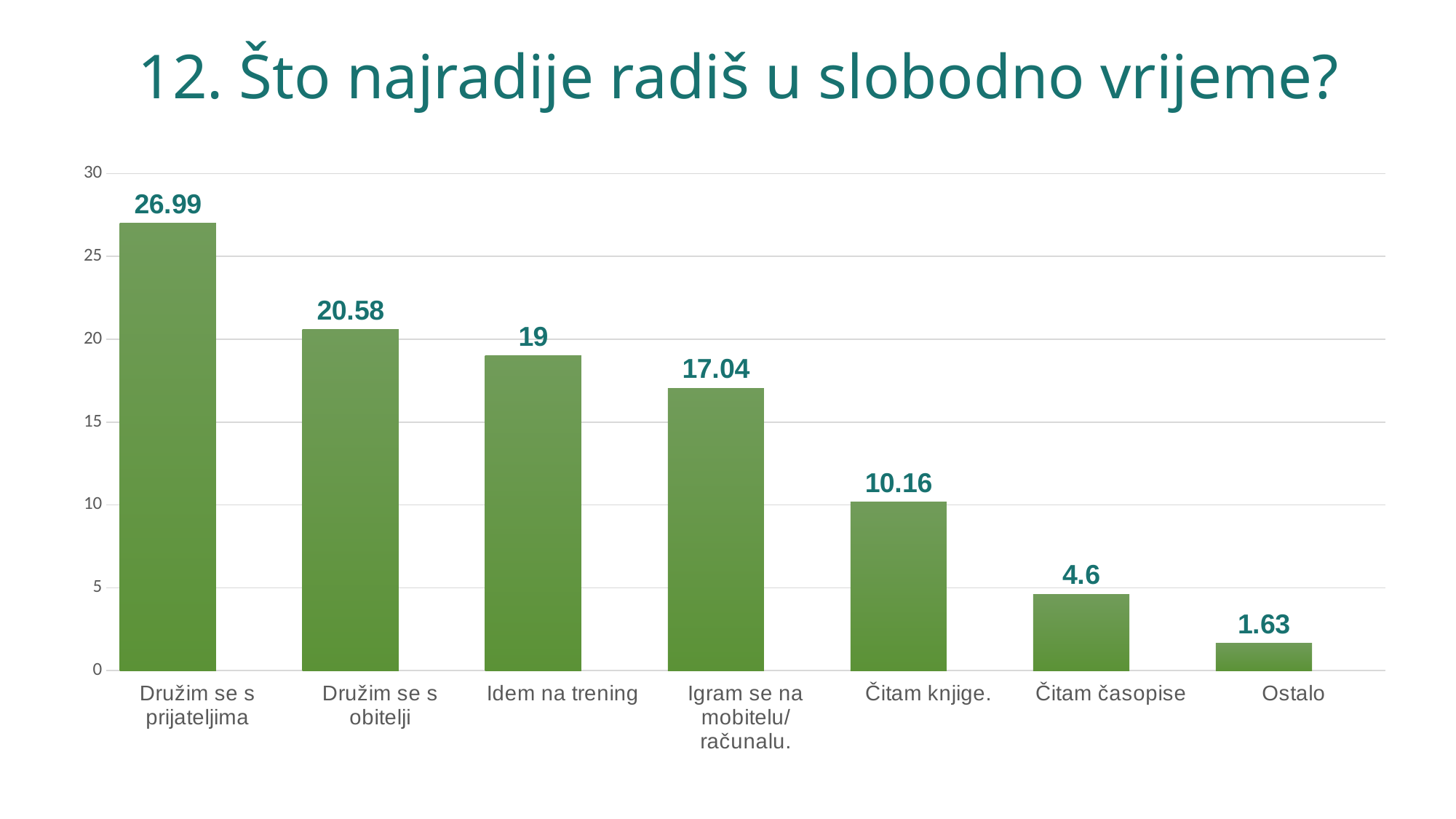
What kind of chart is shown on the slide? bar chart Which category has the lowest value? Ostalo What is the title of the chart? 12. Što najradije radiš u slobodno vrijeme? Do the values rise or fall from left to right along the x axis? fall What is the value for "Idem na trening"? 19 What is the value for "Čitam časopise"? 4.6 What is the difference between the values for "Družim se s obitelji" and "Igram se na mobitelu/računalu."? 3.54 How many categories are shown on the chart? 7 Is the value for "Igram se na mobitelu/računalu." greater or less than 15? greater Which category has the highest value? Družim se s prijateljima Which is larger, the value for "Čitam knjige." or the value for "Čitam časopise"? Čitam knjige. What is the value for "Družim se s prijateljima"? 26.99